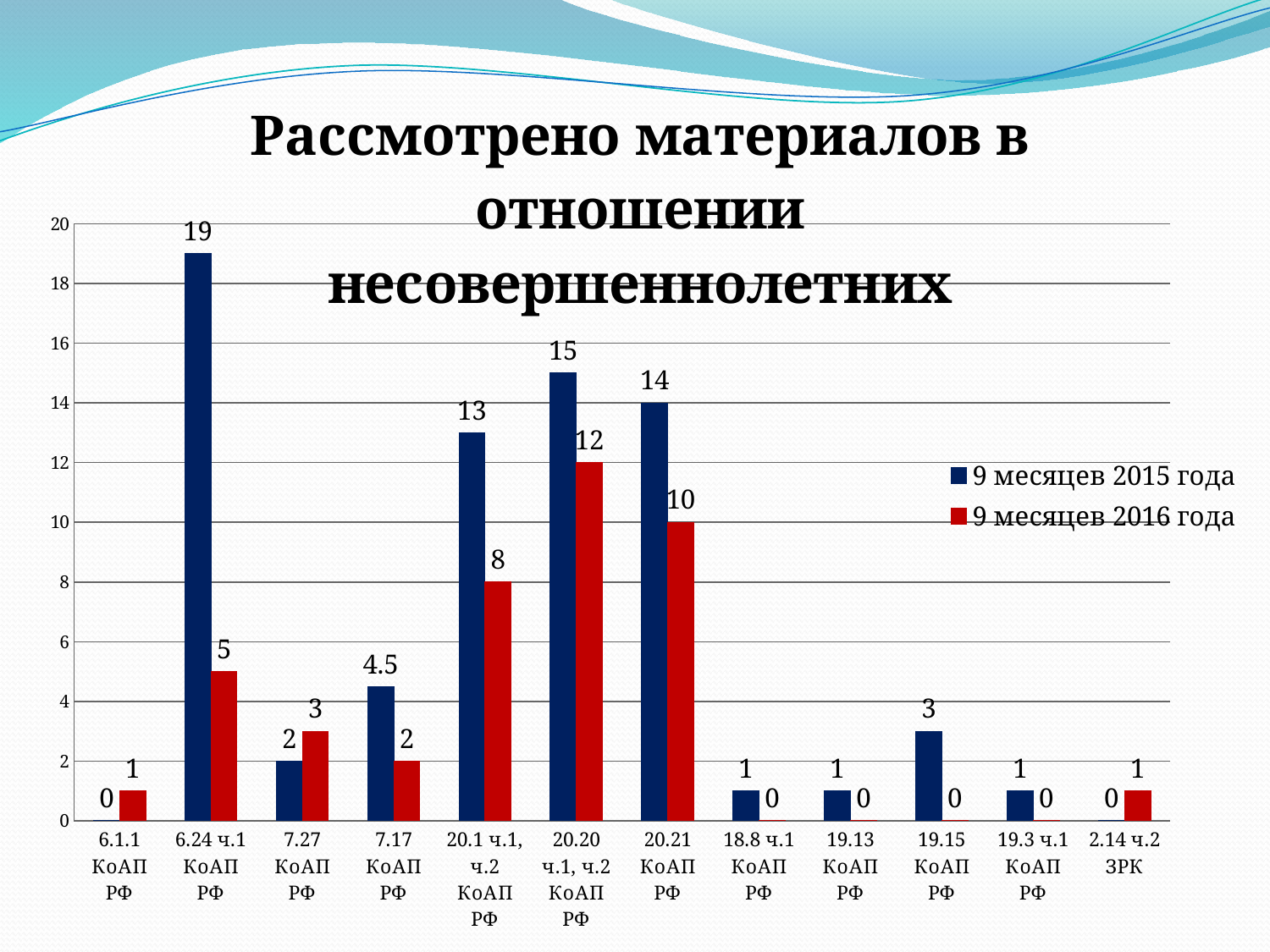
Which category has the highest value in the series 9 месяцев 2016 года? 20.20 ч.1, ч.2 КоАП РФ What is the difference between the 2015 and 2016 values for 20.1 ч.1, ч.2 КоАП РФ? 5 What type of chart is shown on the slide? bar chart How many series does the legend list? 2 What is the value for 20.21 КоАП РФ in the series 9 месяцев 2016 года? 10 How many categories are shown on the x axis? 12 Which category has the highest value in the series 9 месяцев 2015 года? 6.24 ч.1 КоАП РФ What is the value for 7.17 КоАП РФ in the series 9 месяцев 2015 года? 4.5 What colour represents the series 9 месяцев 2016 года? red What is the value for 19.15 КоАП РФ in the series 9 месяцев 2016 года? 0 Which is larger for 7.27 КоАП РФ: the value for 9 месяцев 2015 года or for 9 месяцев 2016 года? 9 месяцев 2016 года What is the value for 6.24 ч.1 КоАП РФ in the series 9 месяцев 2015 года? 19